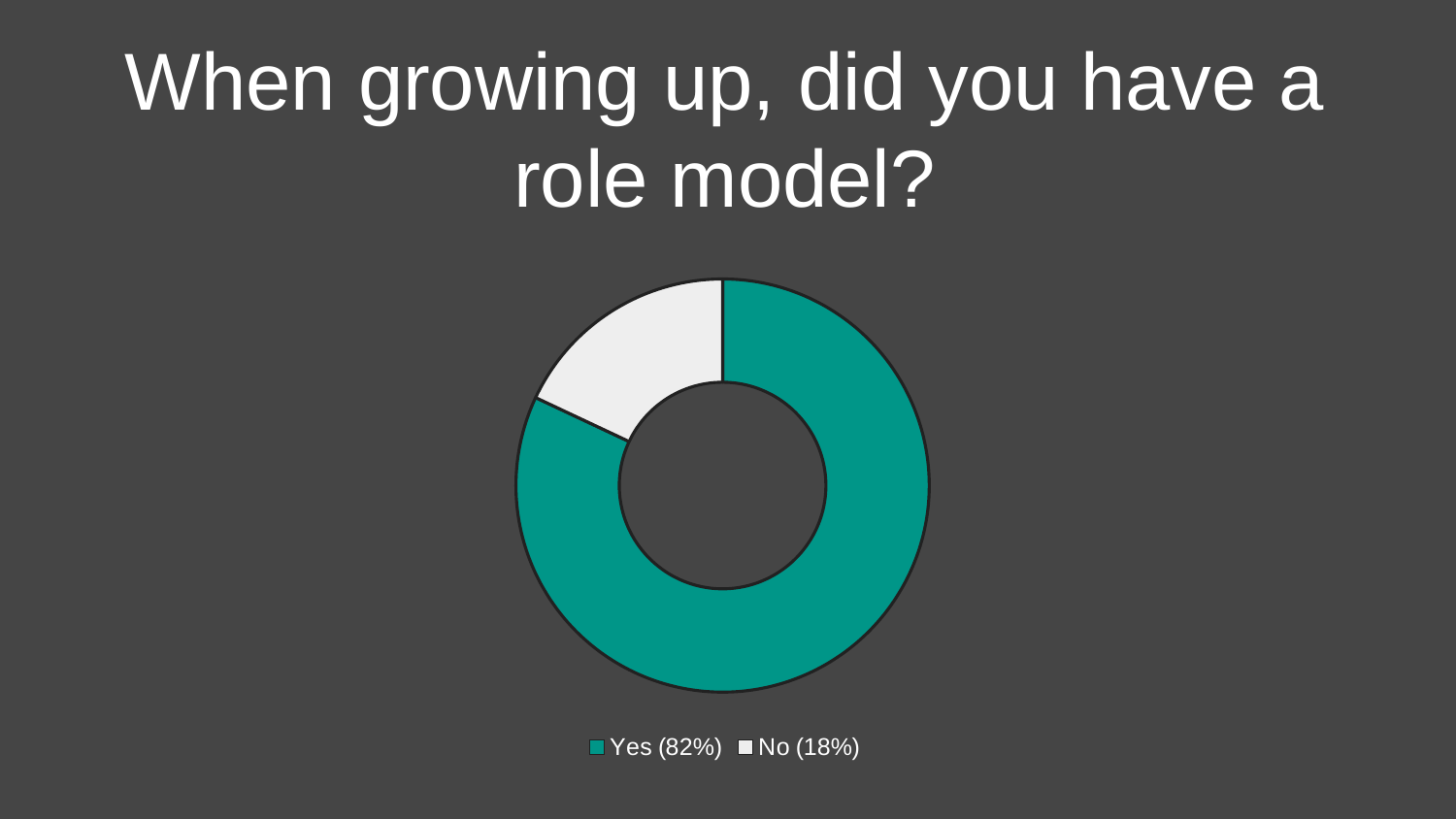
What is the difference in percentage points between Yes and No? 64 What is the title of the slide above the chart? When growing up, did you have a role model? Which response has the largest share of the chart? Yes What colour is the Yes segment of the chart? Teal What percentage of respondents answered Yes? 82% Which is larger, the share for Yes or the share for No? Yes What percentage of respondents answered No? 18% What kind of chart is shown on the slide? Doughnut chart How many categories does the chart show? 2 What share of the chart does the No segment represent? 18% Which response has the smallest share of the chart? No